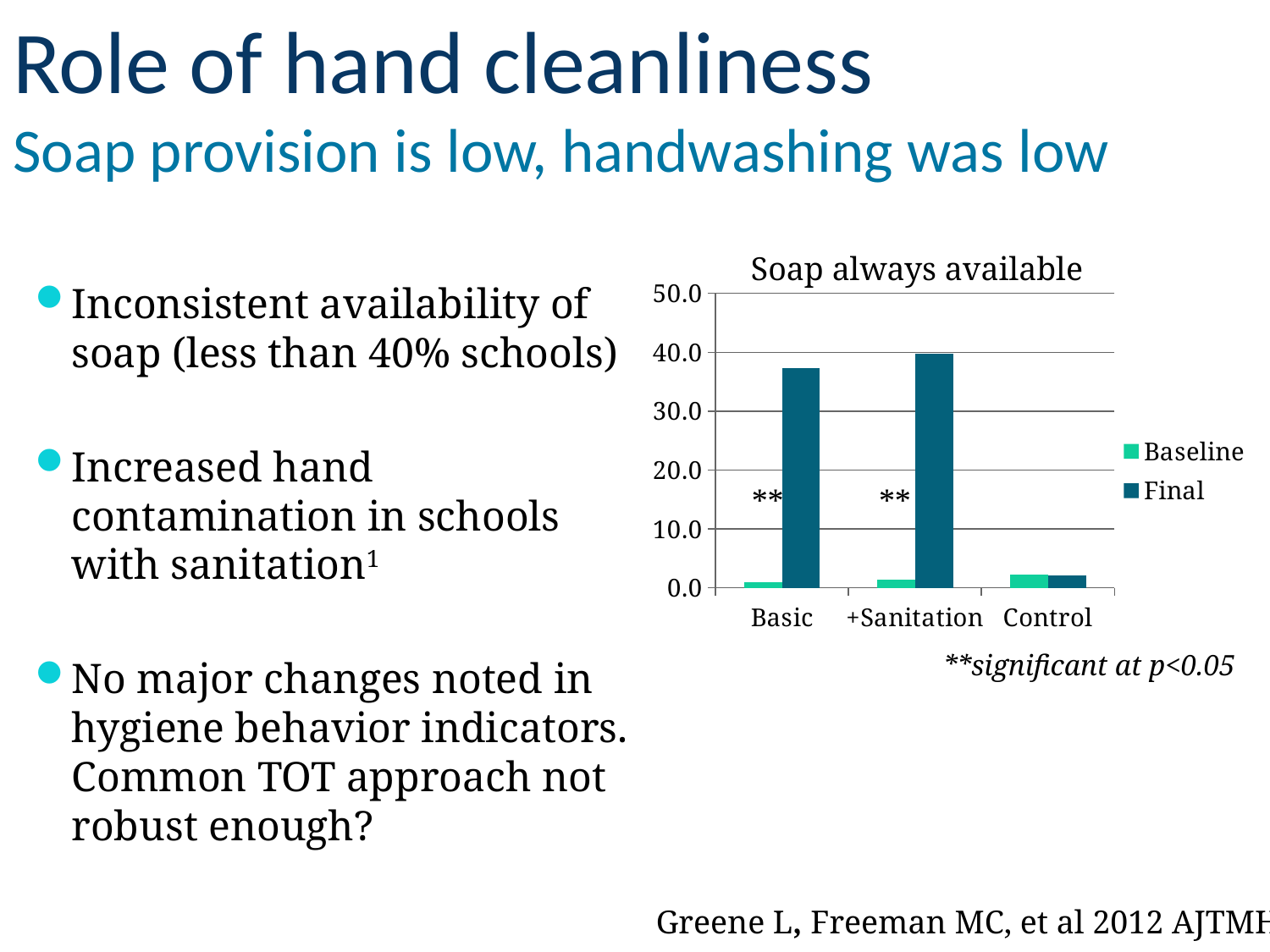
Is the Final value for Basic greater or less than 30.0? greater What type of chart is shown on the slide? bar chart Is the Final value for Basic greater or less than 40.0? less Is the Final value for +Sanitation greater or less than 30.0? greater How many series does the chart legend list? 2 For the Basic category, which is larger: the Baseline value or the Final value? Final What is the title of the chart? Soap always available What are the two series named in the chart legend? Baseline and Final How many categories are shown on the x axis of the chart? 3 Which category has the lowest Final value? Control Which category has the highest Final value? +Sanitation